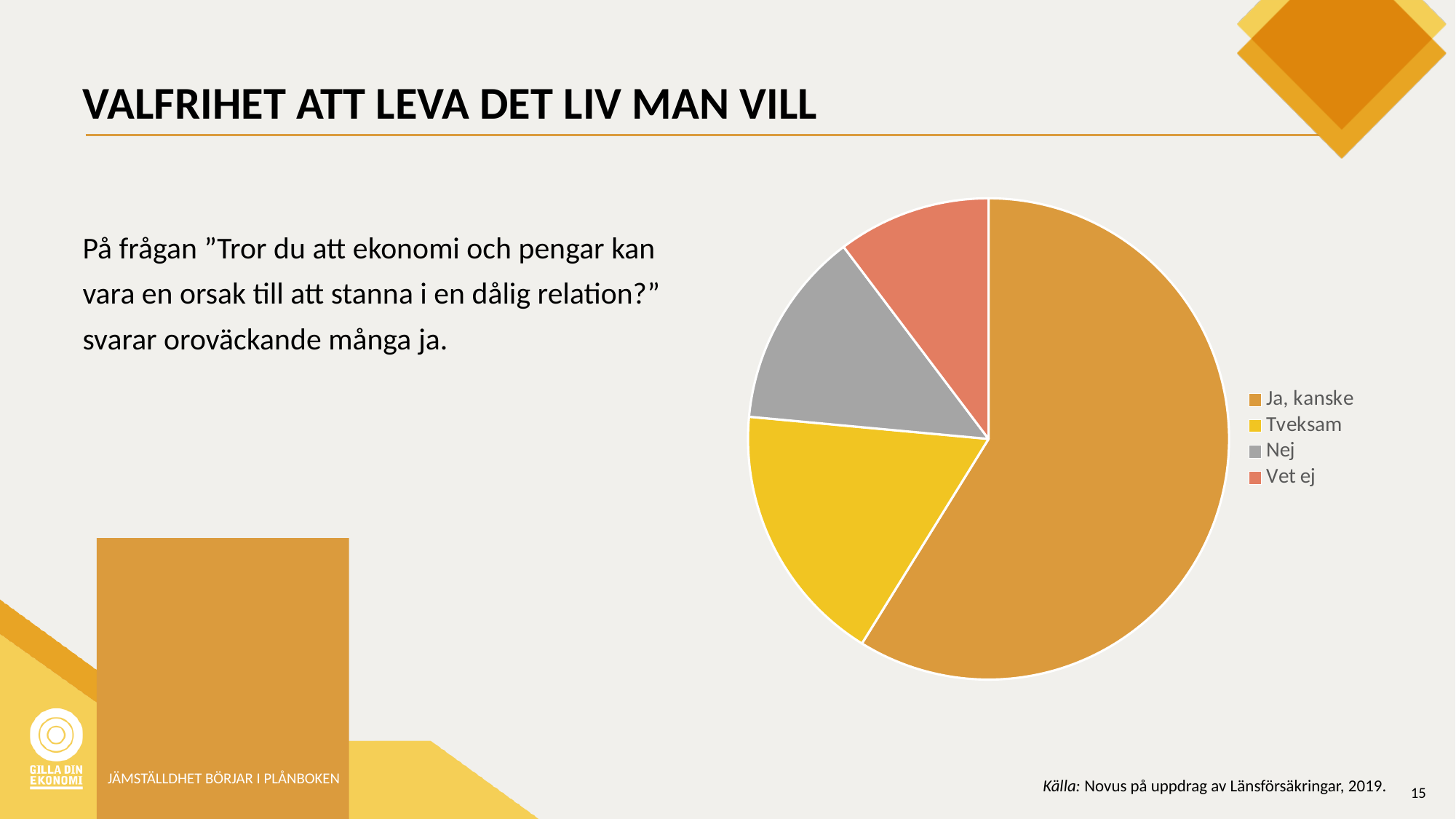
Which slice is larger in the pie chart, Nej or Vet ej? Nej Which slice is larger in the pie chart, Ja, kanske or Tveksam? Ja, kanske How many entries does the legend of the pie chart list? 4 Which category has the largest slice in the pie chart? Ja, kanske Which slice is larger in the pie chart, Tveksam or Vet ej? Tveksam What kind of chart is shown on the slide? Pie chart Which category has the smallest slice in the pie chart? Vet ej How many slices does the pie chart have? 4 Which legend entry is shown in grey in the pie chart? Nej What colour is the Ja, kanske slice in the pie chart? Orange